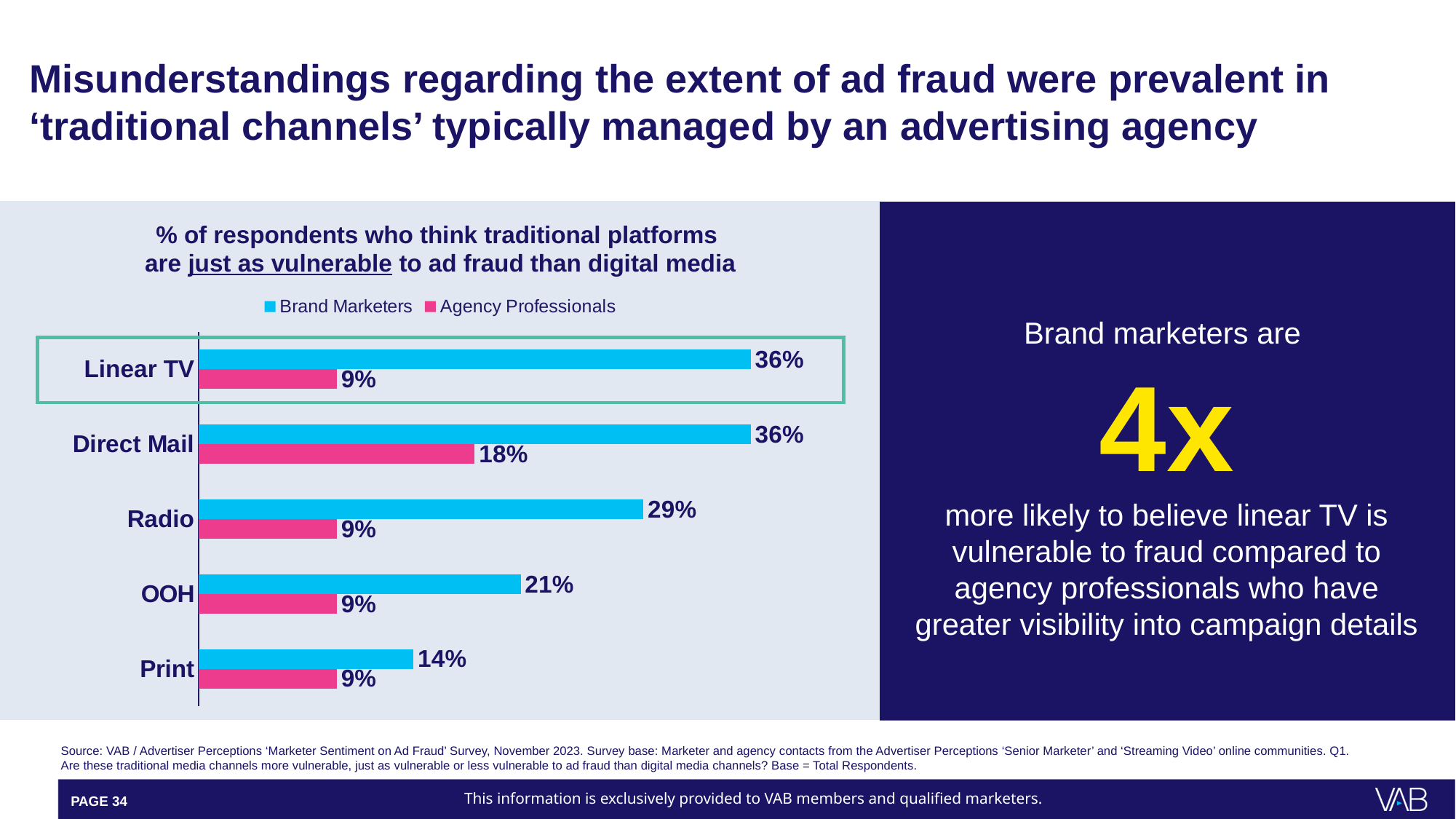
How many media channels are shown in the chart? 5 Which category has the lowest Brand Marketers value? Print What percentage of Brand Marketers think Linear TV is just as vulnerable to ad fraud as digital media? 36% What is the Brand Marketers value for Print? 14% What percentage of Agency Professionals think Direct Mail is just as vulnerable to ad fraud as digital media? 18% What is the Brand Marketers value for Radio? 29% What type of chart is shown on the slide? Bar chart What is the difference between the Brand Marketers values for Radio and OOH? 8 percentage points Which is larger: the Brand Marketers value for OOH or the Agency Professionals value for Direct Mail? Brand Marketers value for OOH What is the difference between the Brand Marketers and Agency Professionals values for Linear TV? 27 percentage points Which category has the highest Agency Professionals value? Direct Mail How many series does the legend list? 2